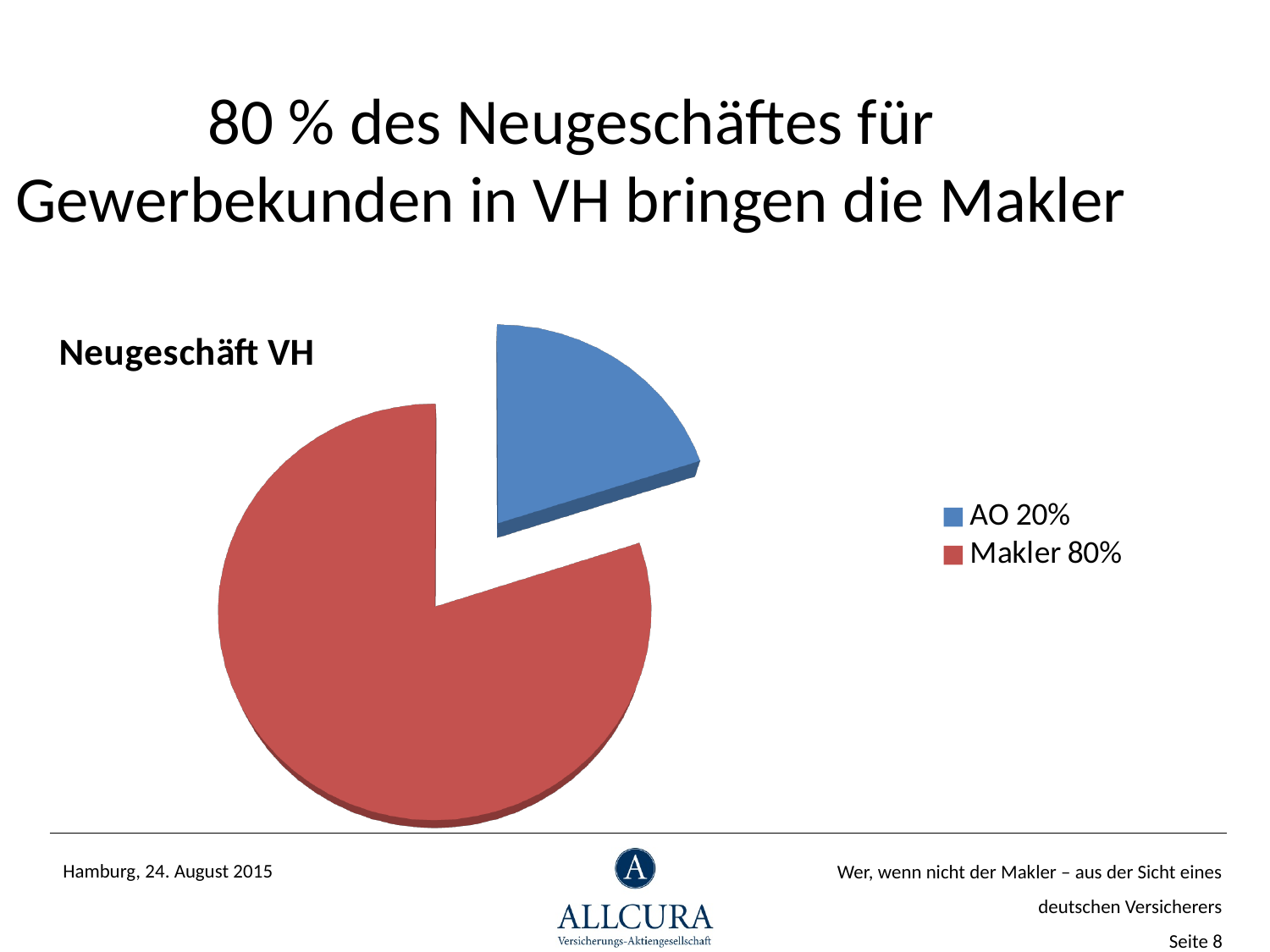
What is the title of the chart? Neugeschäft VH What colour is the Makler slice? red What kind of chart is shown on the slide? pie chart How many entries does the legend list? 2 Which slice is the largest? Makler What is the difference in percentage points between the Makler share and the AO share? 60 percentage points Which slice is the smallest? AO Which is larger, the AO slice or the Makler slice? Makler What share of the pie does AO have? 20% What share of the pie does Makler have? 80% How many slices does the pie chart have? 2